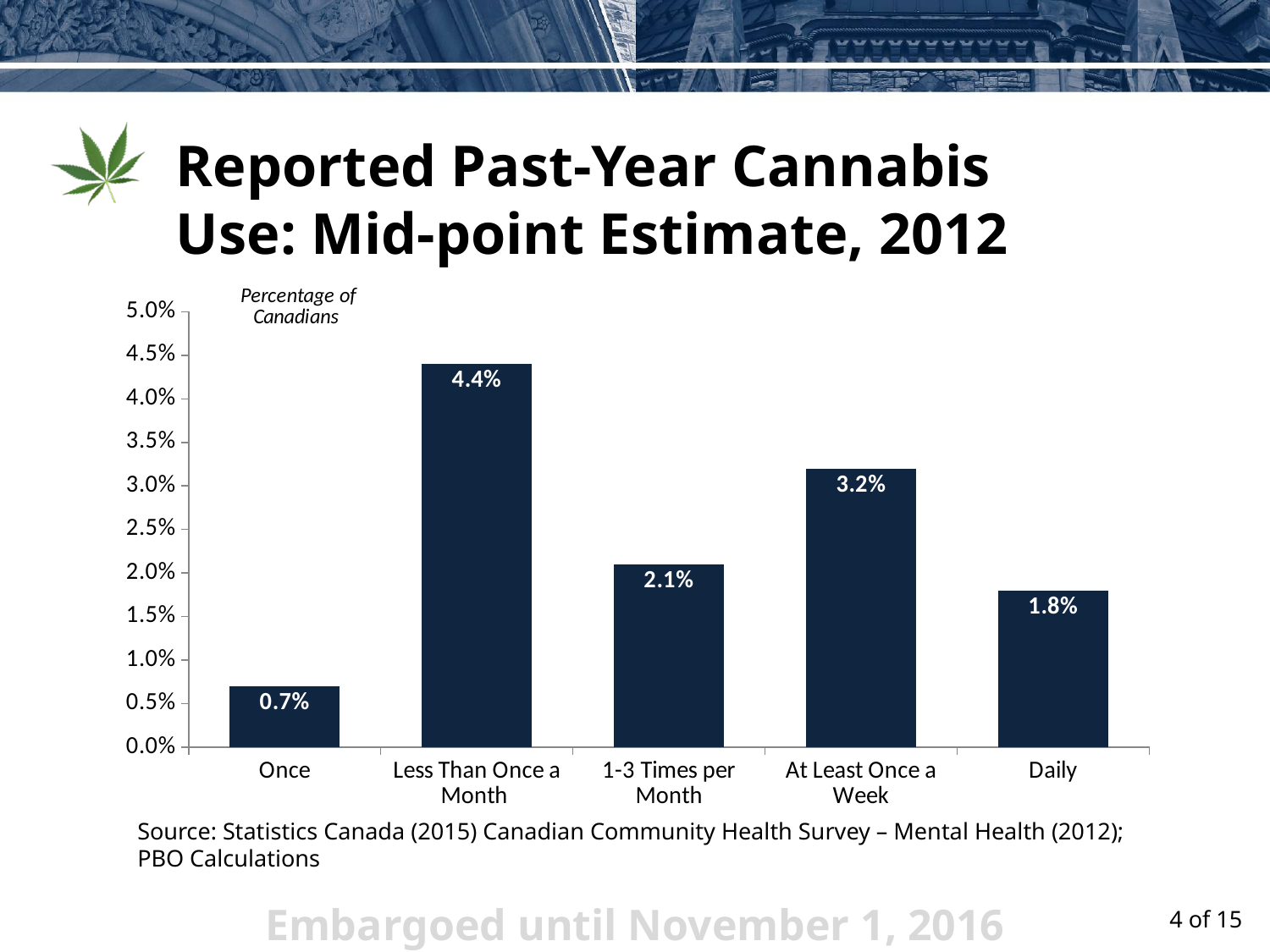
What percentage of Canadians reported using cannabis less than once a month? 4.4% Is the value for At Least Once a Week greater or less than 3.0%? greater What is the difference between the Less Than Once a Month value and the Daily value? 2.6% What kind of chart is shown on the slide? Bar chart What is the value for the Once category? 0.7% Which frequency category has the highest percentage? Less Than Once a Month Which frequency category has the lowest percentage? Once What is the value for the Daily category? 1.8% How many frequency categories are shown on the chart? 5 What is the difference between the At Least Once a Week value and the 1-3 Times per Month value? 1.1% What is the label on the vertical axis of the chart? Percentage of Canadians Which is larger, the value for 1-3 Times per Month or the value for Daily? 1-3 Times per Month